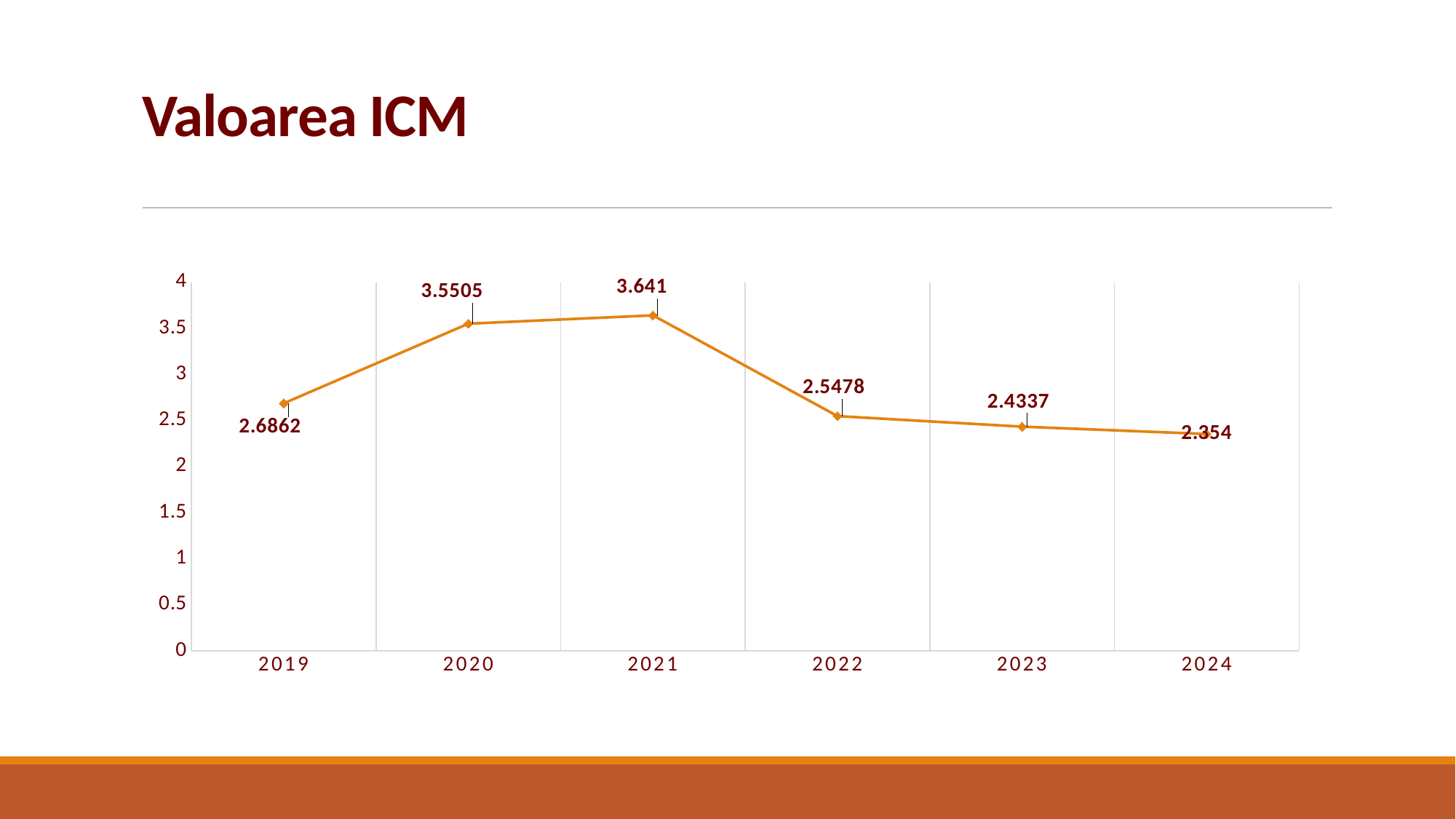
What is the value for 2019? 2.6862 Is the value for 2022 greater or less than 3? less What is the value for 2021? 3.641 What is the value for 2024? 2.354 How many years are plotted on the chart? 6 What is the difference between the values for 2021 and 2019? 0.9548 What is the difference between the values for 2020 and 2022? 1.0027 Which is larger, the value for 2020 or the value for 2023? 2020 What kind of chart is shown on the slide? line chart Do the values rise or fall from 2021 to 2024? fall Which year has the highest value? 2021 Which year has the lowest value? 2024